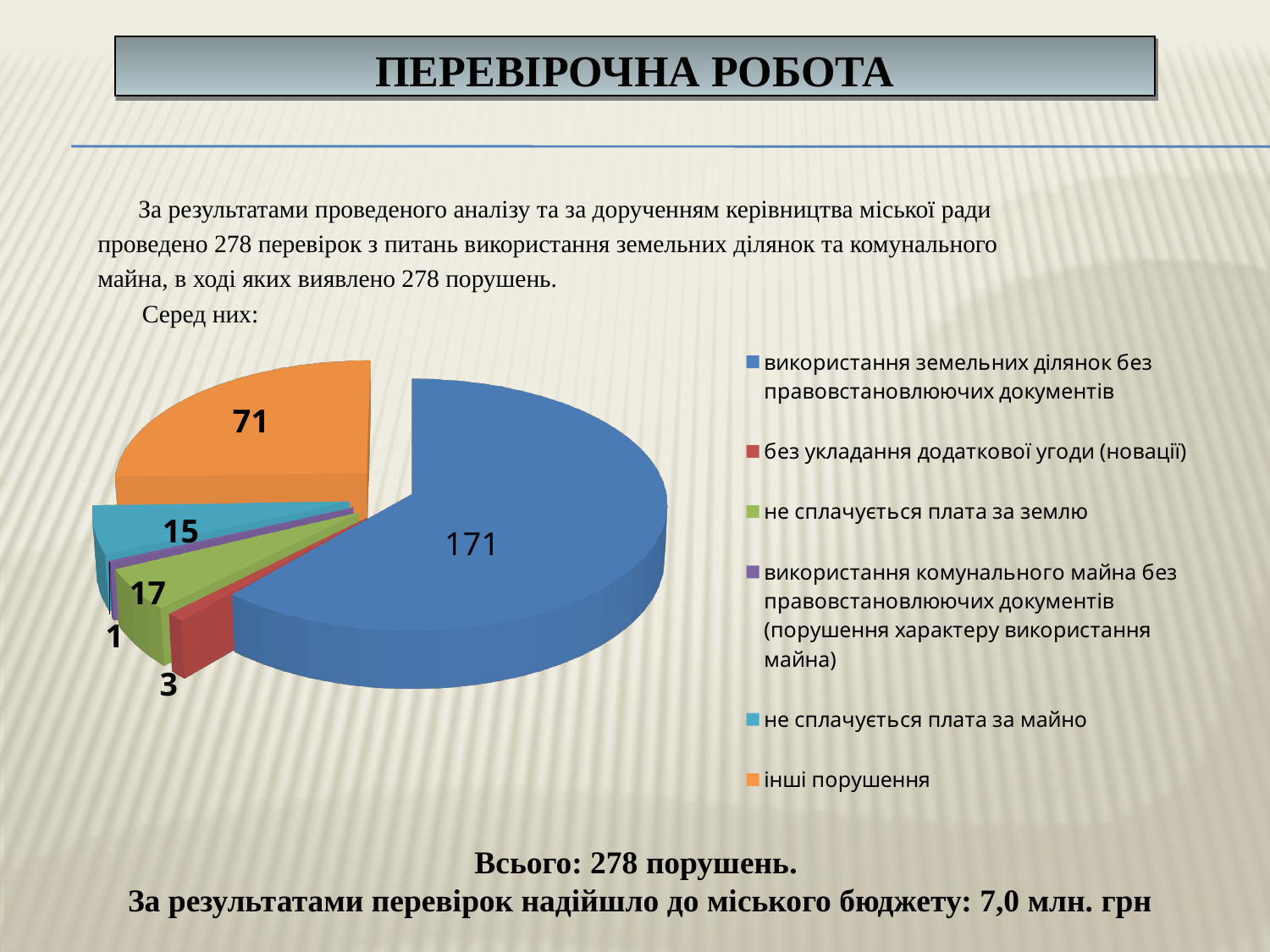
What is the value for "не сплачується плата за майно"? 15 What is the value for "не сплачується плата за землю"? 17 What is the value for "без укладання додаткової угоди (новації)"? 3 What is the value for "інші порушення"? 71 Which category has the largest slice of the pie? використання земельних ділянок без правовстановлюючих документів Which is larger: the value for "не сплачується плата за землю" or the value for "не сплачується плата за майно"? не сплачується плата за землю What is the difference between the value for "використання земельних ділянок без правовстановлюючих документів" and the value for "інші порушення"? 100 What kind of chart is shown on the slide? pie chart How many entries does the legend of the pie chart list? 6 What is the value for "використання земельних ділянок без правовстановлюючих документів"? 171 How many slices does the pie chart have? 6 Which category has the smallest slice of the pie? використання комунального майна без правовстановлюючих документів (порушення характеру використання майна)